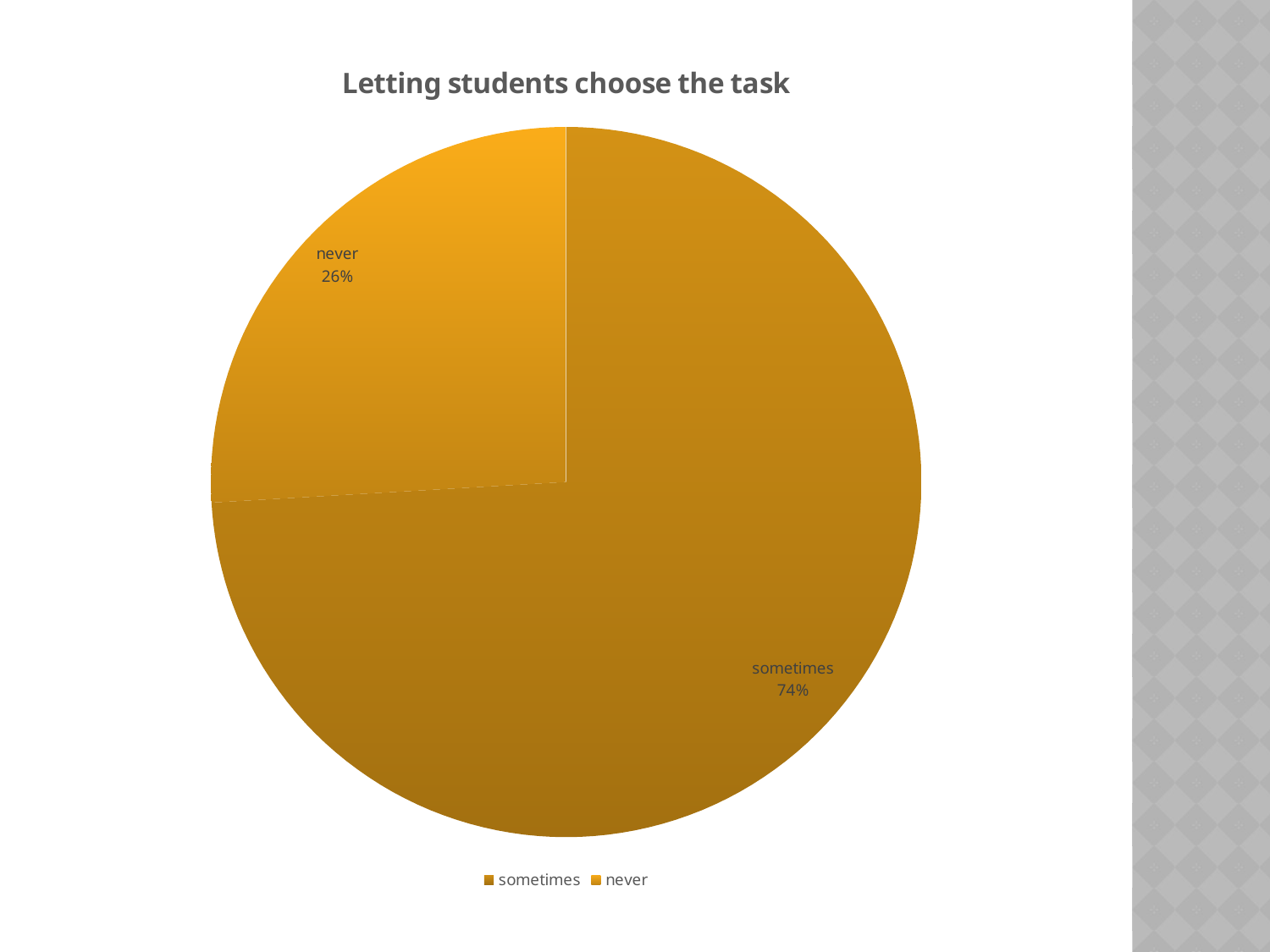
Which legend entry is listed first? sometimes What share of the pie does the "sometimes" slice represent? 74% Which category has the smallest slice of the pie? never What is the title of the chart? Letting students choose the task What kind of chart is shown on the slide? pie chart Which is larger, the "sometimes" slice or the "never" slice? sometimes How many slices does the pie chart have? 2 How many entries does the legend list? 2 What is the difference in percentage points between the "sometimes" and "never" slices? 48 Which category has the largest slice of the pie? sometimes What share of the pie does the "never" slice represent? 26%